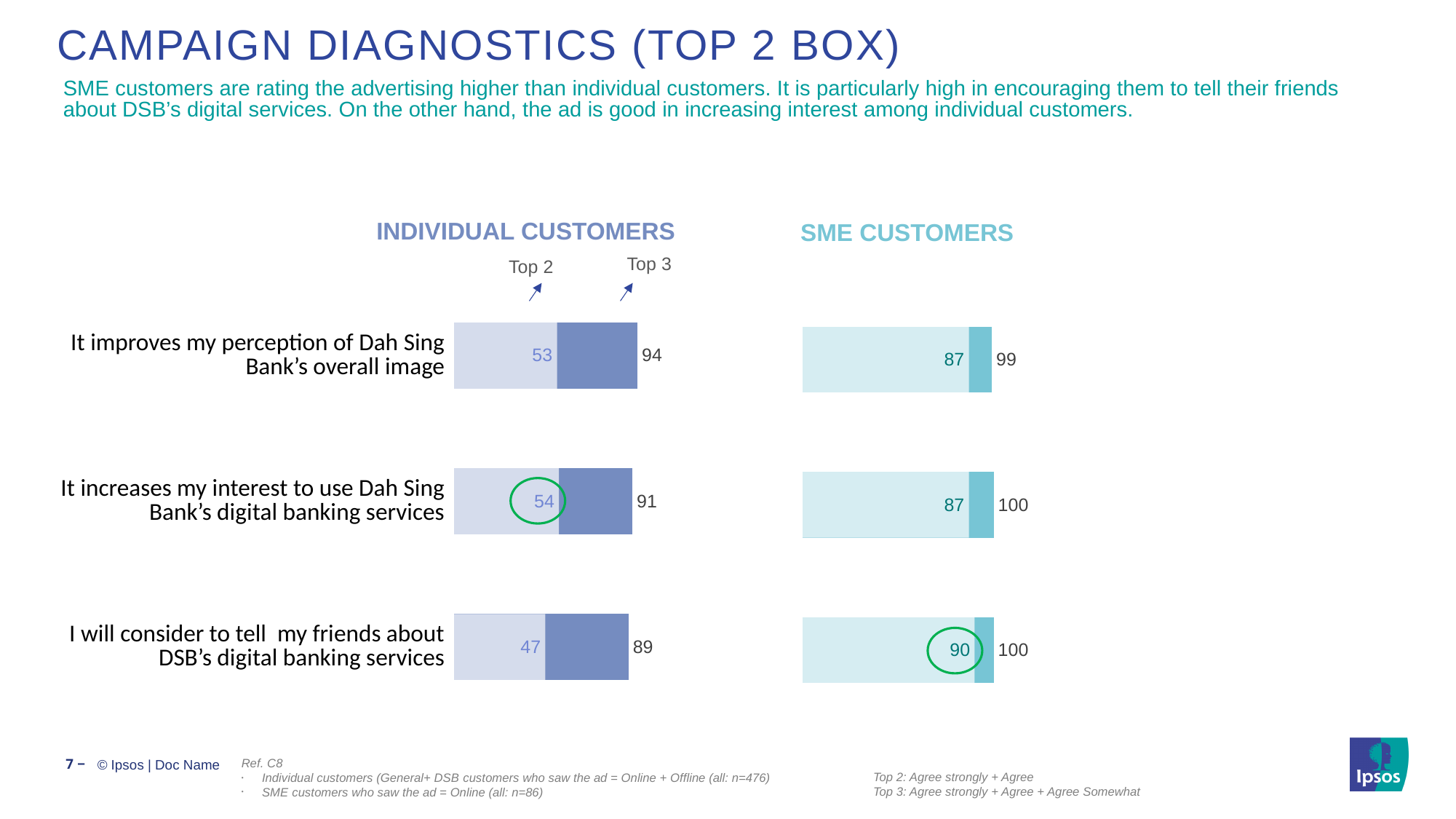
Which is larger: the Individual Customers Top 2 value for "It increases my interest to use Dah Sing Bank's digital banking services" or for "I will consider to tell my friends about DSB's digital banking services"? It increases my interest to use Dah Sing Bank's digital banking services What kind of chart is used for the Individual Customers data? Bar chart In the Individual Customers chart, which statement has the lowest Top 3 value? I will consider to tell my friends about DSB's digital banking services What is the difference between the SME Customers Top 2 value and the Individual Customers Top 2 value for "I will consider to tell my friends about DSB's digital banking services"? 43 In the SME Customers chart, what is the Top 3 value for "I will consider to tell my friends about DSB's digital banking services"? 100 In the SME Customers chart, what is the Top 2 value for "It improves my perception of Dah Sing Bank's overall image"? 87 In the Individual Customers chart, which statement has the highest Top 2 value? It increases my interest to use Dah Sing Bank's digital banking services In the Individual Customers chart, what is the difference between the Top 3 and Top 2 values for "It improves my perception of Dah Sing Bank's overall image"? 41 How many statements are plotted in the SME Customers chart? 3 In the SME Customers chart, which statement has the highest Top 2 value? I will consider to tell my friends about DSB's digital banking services In the Individual Customers chart, what is the Top 3 value for "It increases my interest to use Dah Sing Bank's digital banking services"? 91 In the Individual Customers chart, what is the Top 2 value for "It improves my perception of Dah Sing Bank's overall image"? 53